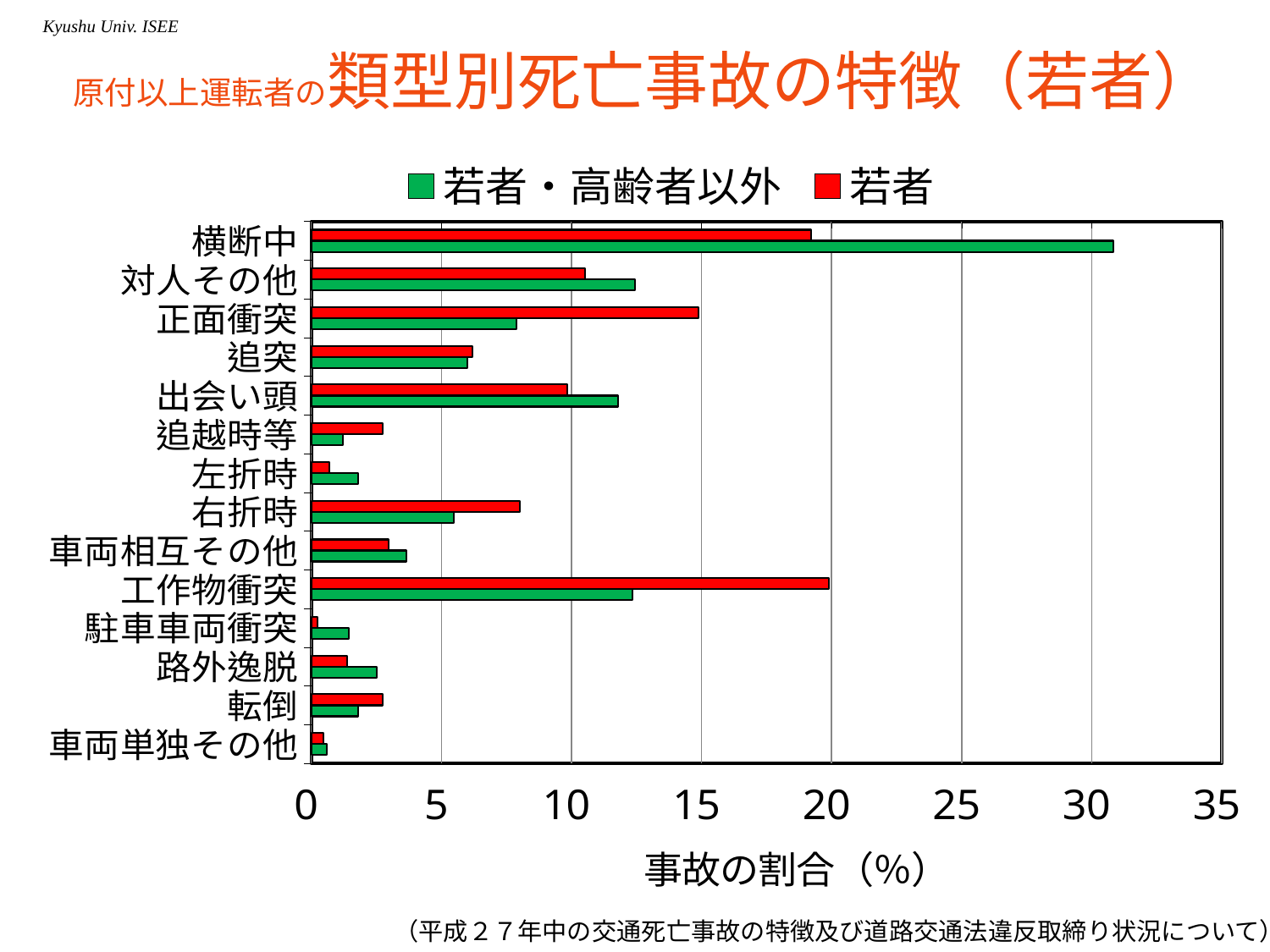
How many accident-type categories are plotted on the y axis? 14 For 正面衝突, which series has the larger value, 若者 or 若者・高齢者以外? 若者 For 横断中, which series has the larger value, 若者 or 若者・高齢者以外? 若者・高齢者以外 What is the label of the x axis? 事故の割合（%） What kind of chart is shown on the slide? bar chart How many series does the legend list? 2 Is the 若者・高齢者以外 value for 横断中 greater or less than 30? greater Is the 若者・高齢者以外 value for 出会い頭 greater or less than 10? greater Which category has the highest value for the 若者・高齢者以外 series? 横断中 Which colour represents the 若者 series in the chart? red For 工作物衝突, which series has the larger value, 若者 or 若者・高齢者以外? 若者 Is the 若者 value for 右折時 greater or less than 5? greater